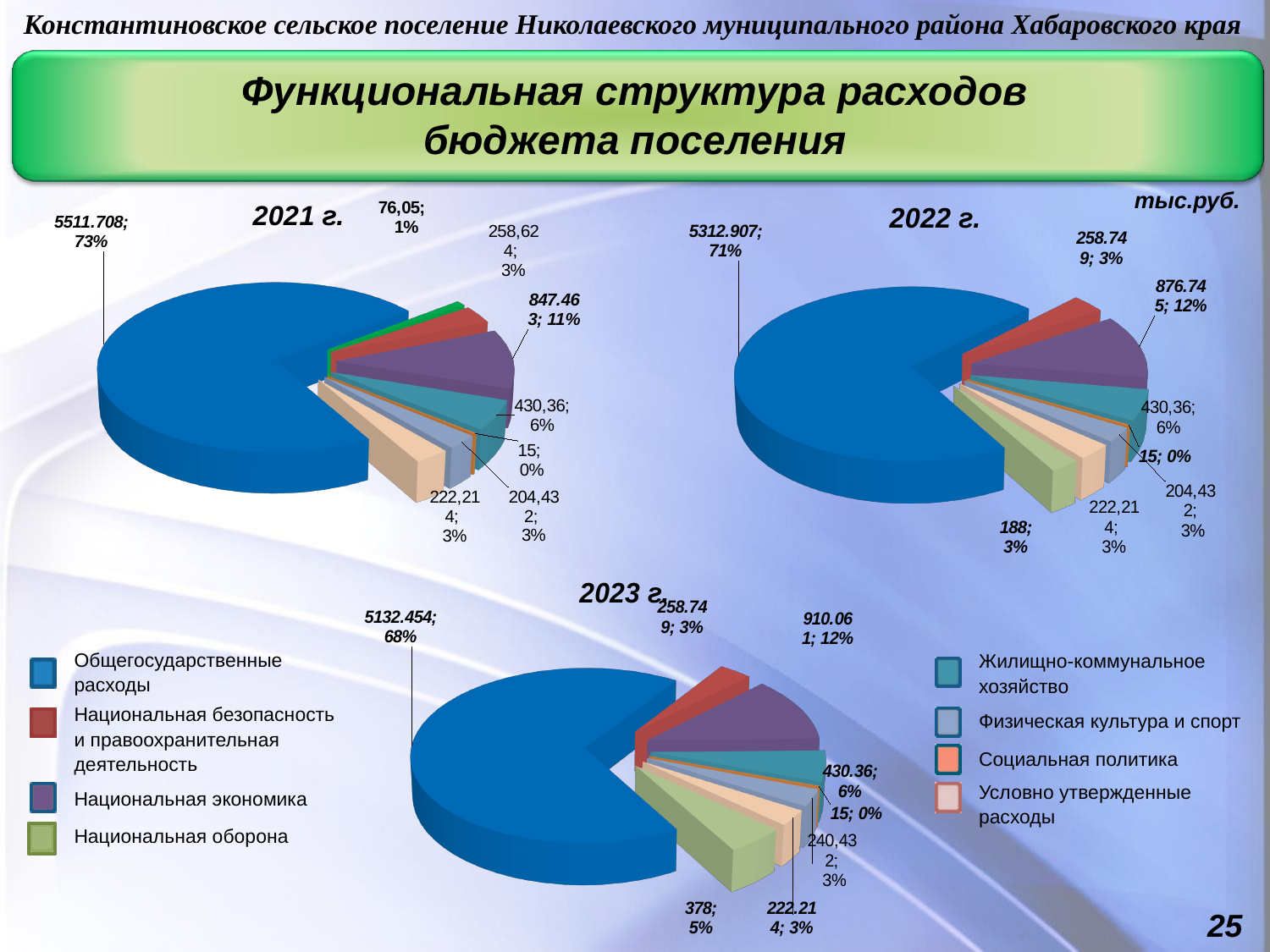
On the 2021 pie chart, what is the value of the slice labelled 1%? 76,05 On the 2021 pie chart, what share of expenditure does the largest slice (Общегосударственные расходы) account for? 73% How many expenditure categories does the legend list? 8 Does the share of the largest slice rise or fall from the 2021 chart to the 2023 chart? Falls In what units are the values on the charts given? тыс.руб. What is the difference between the largest slice value on the 2021 chart (5511.708) and the largest slice value on the 2022 chart (5312.907)? 198.801 On the 2023 pie chart, what share does the largest slice account for? 68% On the 2023 pie chart, what is the value of the slice labelled 12%? 910.061 On the 2023 pie chart, what is the value of the slice labelled 5%? 378 On the 2022 pie chart, what share does the largest slice account for? 71% What kind of charts are shown on the slide? Pie charts On the 2022 pie chart, what is the value of the slice labelled 12%? 876.745